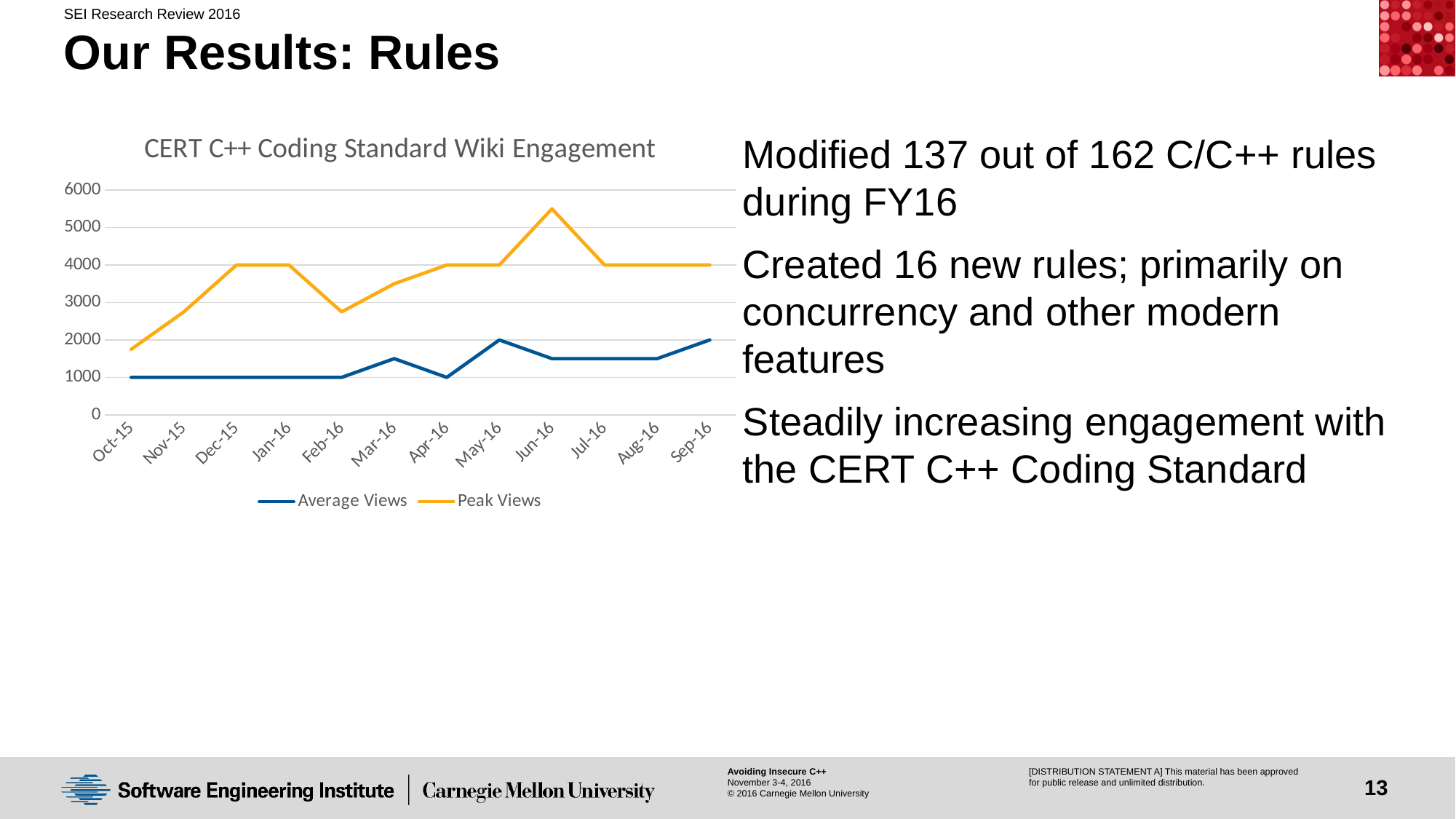
What is the Average Views value for Oct-15? 1000 What is the Peak Views value for Dec-15? 4000 What is the title of the chart? CERT C++ Coding Standard Wiki Engagement How many months are shown on the x axis of the chart? 12 In which month does Peak Views reach its highest value? Jun-16 In which month is Peak Views at its lowest? Oct-15 What is the Average Views value for Sep-16? 2000 Is the Peak Views value for Feb-16 greater or less than 3000? less Which series is higher in Jun-16, Average Views or Peak Views? Peak Views What type of chart is shown on the slide? line chart Is the Peak Views value for Jun-16 greater or less than 5000? greater How many series does the chart legend list? 2